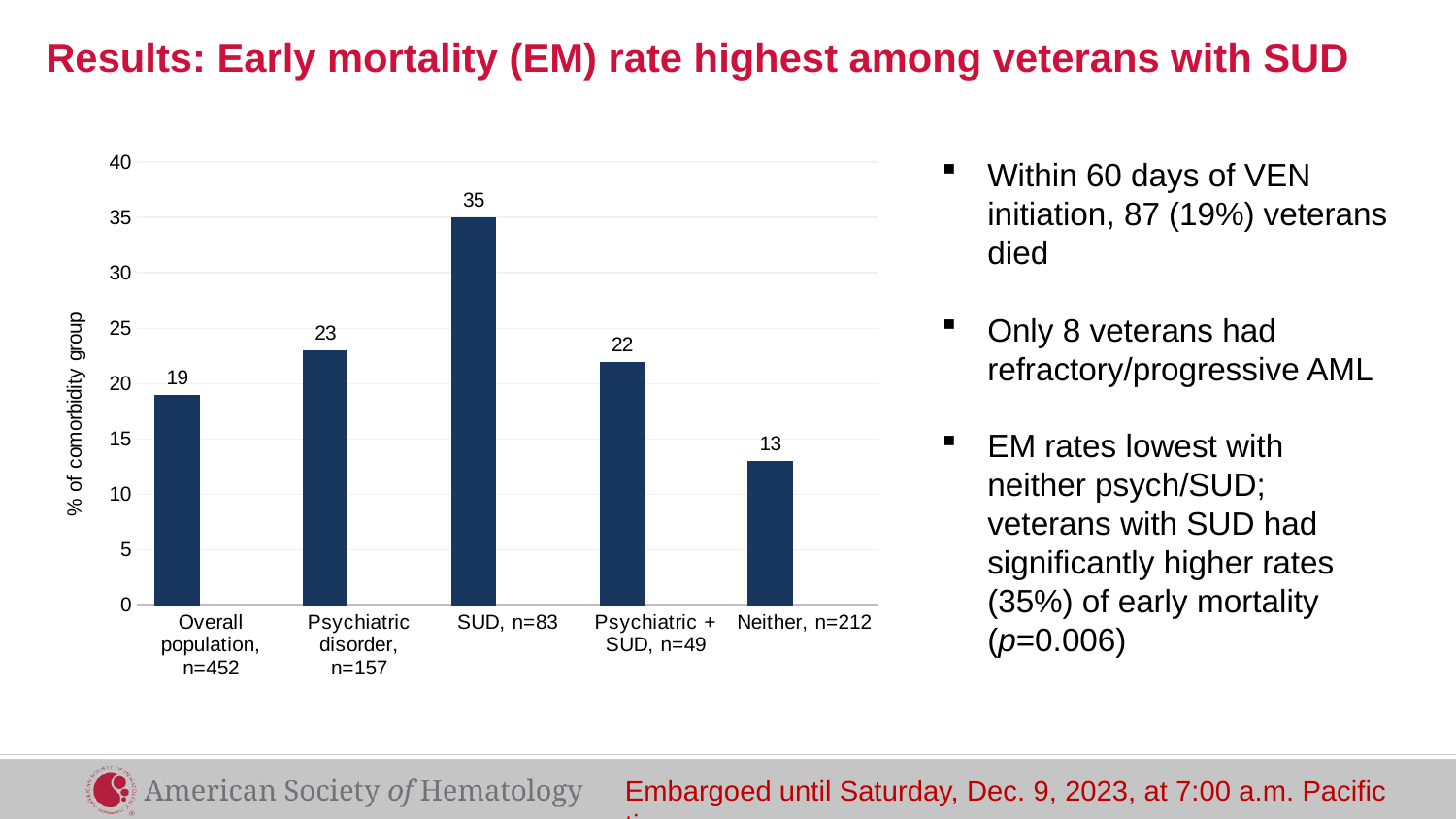
What is the value for the Overall population, n=452 group? 19 Which comorbidity group has the lowest value? Neither, n=212 What is the difference between the values for SUD, n=83 and Neither, n=212? 22 What is the value for the Psychiatric disorder, n=157 group? 23 Which comorbidity group has the highest value? SUD, n=83 Is the value for Psychiatric + SUD, n=49 greater or less than 20? greater What kind of chart is shown on the slide? Bar chart What is the value for the Neither, n=212 group? 13 What is the label of the y axis? % of comorbidity group How many comorbidity groups are shown on the x axis? 5 Which is larger, the value for Psychiatric disorder, n=157 or Psychiatric + SUD, n=49? Psychiatric disorder, n=157 What is the early mortality rate for the SUD, n=83 group? 35